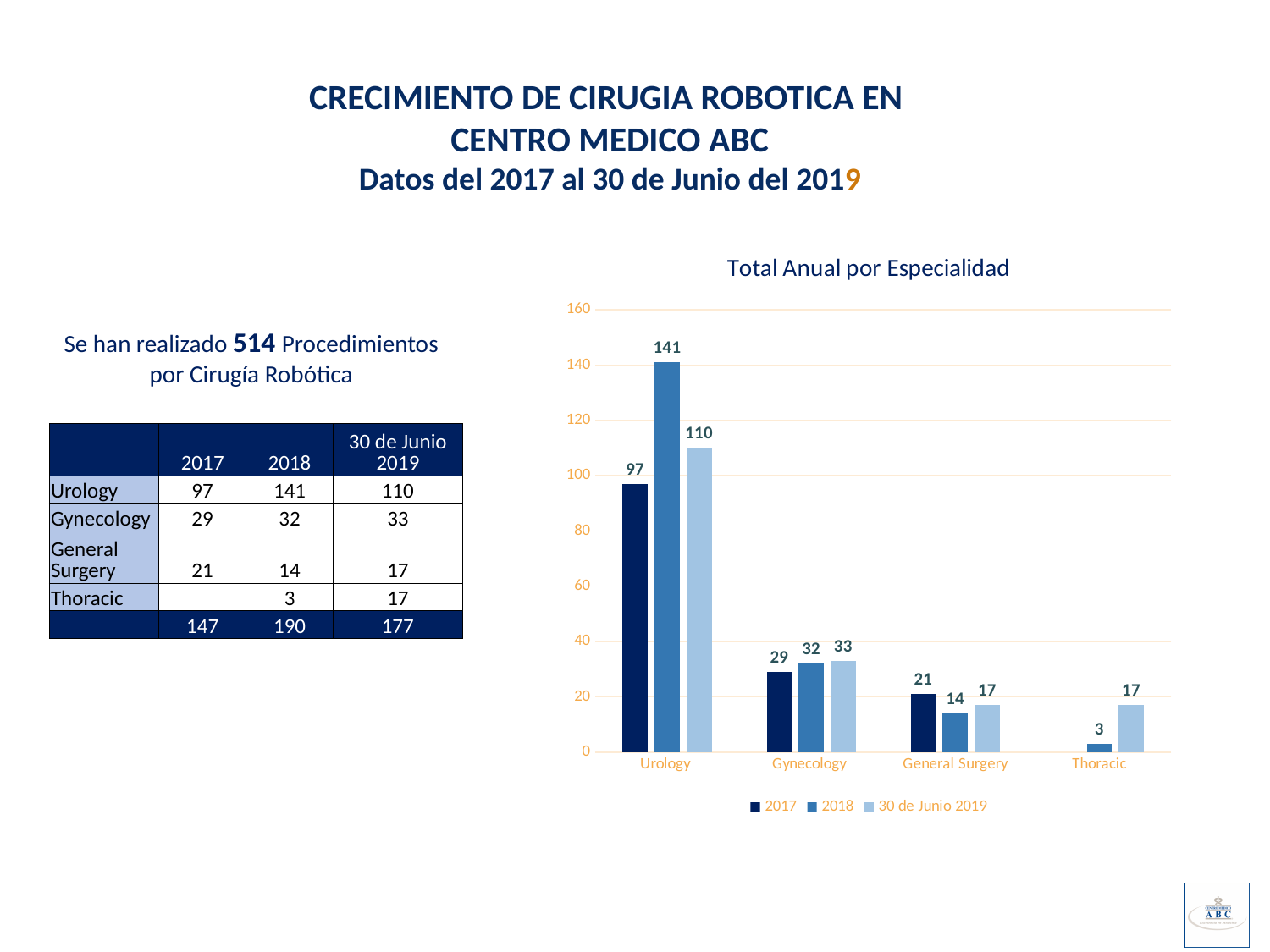
How many categories are shown on the x axis? 4 What is the value for General Surgery in the 2017 series? 21 What is the title of the chart? Total Anual por Especialidad What is the difference between the 2018 and 2017 values for Urology? 44 What kind of chart is shown? bar chart Which category has the highest value in the 2018 series? Urology What is the value for Urology in the 2018 series? 141 Which category has the lowest value in the 2018 series? Thoracic Is the value for Urology in the 30 de Junio 2019 series greater or less than 100? greater What is the value for Thoracic in the 30 de Junio 2019 series? 17 How many series does the legend list? 3 Which is larger for General Surgery: the 2017 value or the 2018 value? 2017